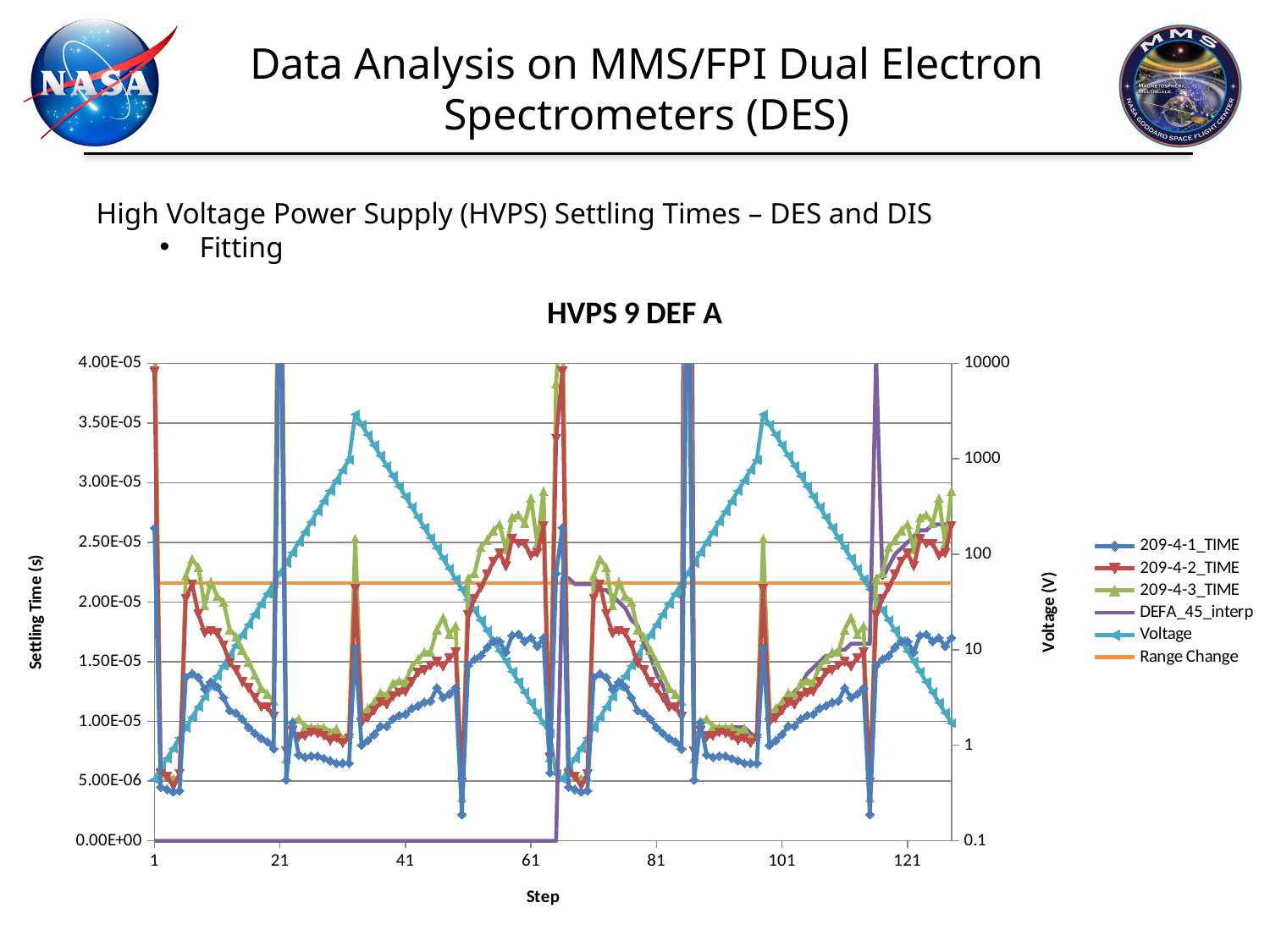
What kind of chart is shown on the slide? line chart Does the Range Change series rise, fall, or stay flat across the steps? stays flat What is the highest value shown on the left Settling Time (s) axis? 4.00E-05 Is the peak of the Voltage series near step 37 greater or less than 1000 V? greater Of the three _TIME series, which one generally lies highest on the chart? 209-4-3_TIME Is the Voltage value at step 1 greater or less than 1 V? less What is the lowest value shown on the right Voltage (V) axis? 0.1 How many labeled tick marks are on the Step axis? 7 What is the title of the chart? HVPS 9 DEF A Is the 209-4-1_TIME value at step 1 greater or less than 2.00E-05? greater Which series in the chart is drawn as a flat horizontal line? Range Change How many series does the legend of the HVPS 9 DEF A chart list? 6